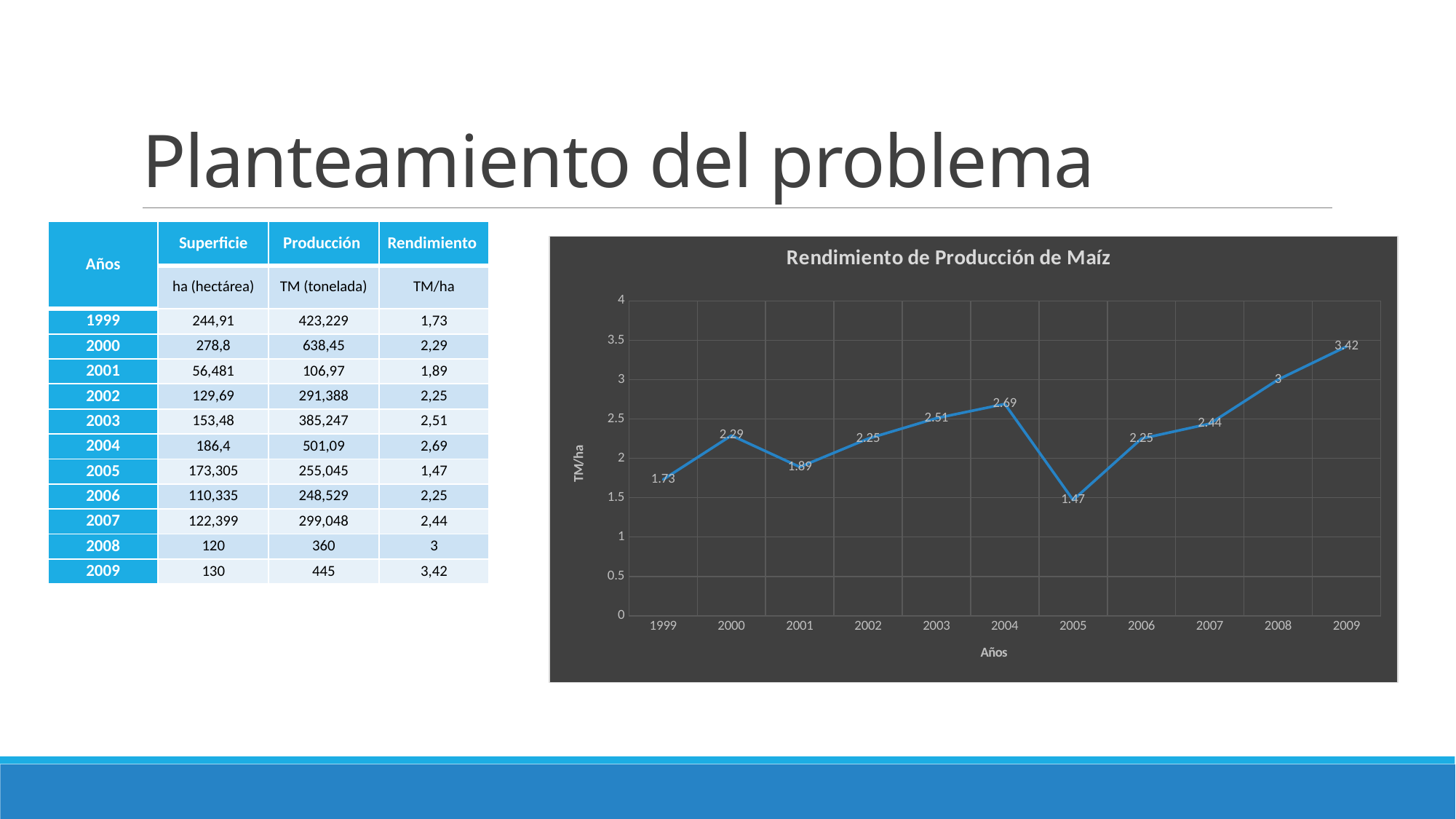
Is the value for 2008 in the Rendimiento de Producción de Maíz chart greater or less than 2.5? greater Which is larger in the Rendimiento de Producción de Maíz chart, the value for 2004 or the value for 2007? 2004 What is the difference between the values for 2009 and 2005 in the Rendimiento de Producción de Maíz chart? 1.95 What is the value for 2005 in the Rendimiento de Producción de Maíz chart? 1.47 Which year has the lowest value in the Rendimiento de Producción de Maíz chart? 2005 What kind of chart is the Rendimiento de Producción de Maíz chart? line chart What is the value for 2003 in the Rendimiento de Producción de Maíz chart? 2.51 What is the value for 2009 in the Rendimiento de Producción de Maíz chart? 3.42 How many years are plotted on the x axis of the Rendimiento de Producción de Maíz chart? 11 Does the value rise or fall from 2004 to 2005 in the Rendimiento de Producción de Maíz chart? fall What is the y-axis label of the Rendimiento de Producción de Maíz chart? TM/ha Which year has the highest value in the Rendimiento de Producción de Maíz chart? 2009